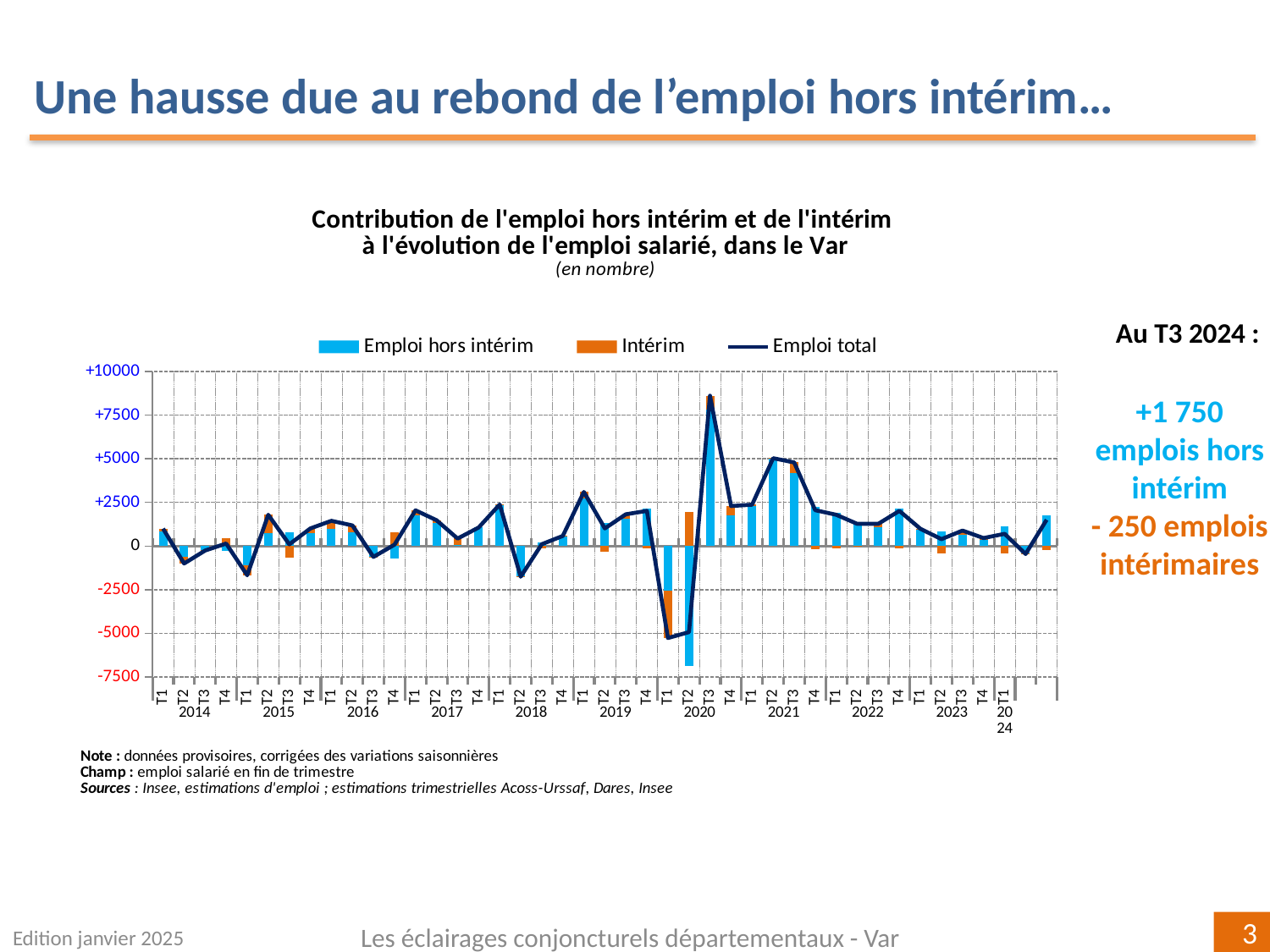
Which is larger, the Emploi total value at T3 2020 or at T2 2021? T3 2020 Is the Emploi total value at T2 2021 greater or less than 2500? greater Is the Emploi hors intérim value at T2 2020 greater or less than -5000? less According to the slide, what is the value for Intérim at T3 2024? -250 How many series does the chart legend list? 3 In which quarter does the Emploi total line reach its highest value? T3 2020 In which quarter is the Emploi hors intérim bar at its lowest? T2 2020 According to the slide, what is the value for Emploi hors intérim at T3 2024? +1 750 Is the Emploi total value at T3 2020 greater or less than 7500? greater Which series is drawn as a line rather than bars? Emploi total Between T2 2020 and T3 2020, does the Emploi total line rise or fall? rise What kind of chart is shown on the slide? A combined bar and line chart